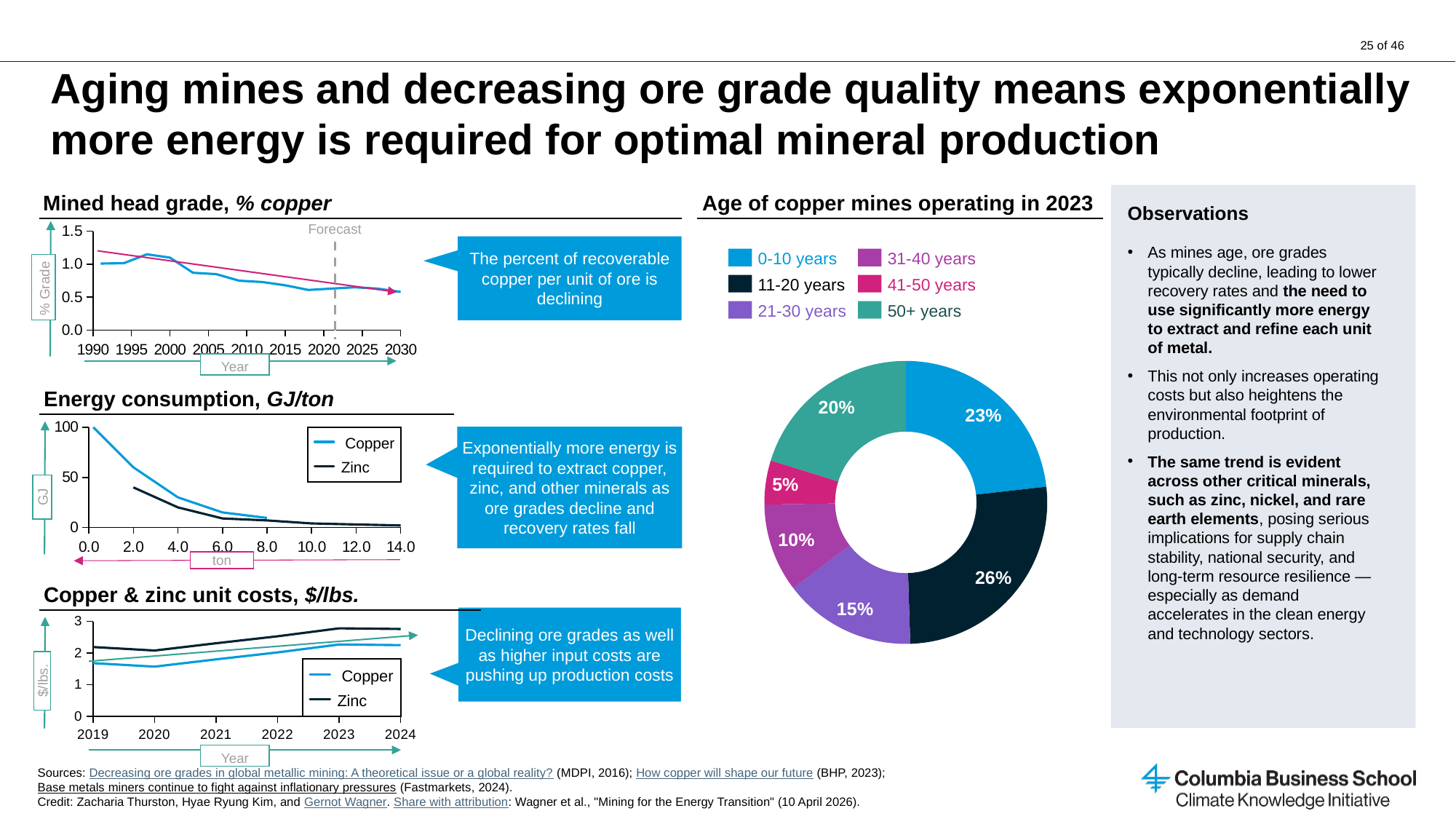
In the 'Mined head grade, % copper' chart, does the head grade rise or fall from 1990 to 2030? Fall How many series does the legend of the 'Energy consumption, GJ/ton' chart list? 2 In the 'Age of copper mines operating in 2023' chart, what share of mines are 50+ years old? 20% What kind of chart is 'Age of copper mines operating in 2023'? Pie (donut) chart In the 'Age of copper mines operating in 2023' chart, what share of mines are 11-20 years old? 26% How many age groups does the legend of the 'Age of copper mines operating in 2023' chart list? 6 In the 'Age of copper mines operating in 2023' chart, which age group has the smallest share? 41-50 years In the 'Age of copper mines operating in 2023' chart, what is the difference between the shares for 0-10 years and 21-30 years? 8% In the 'Copper & zinc unit costs, $/lbs.' chart, is the value for Zinc in 2023 greater or less than 2? greater In the 'Age of copper mines operating in 2023' chart, which is larger: the share for 31-40 years or the share for 50+ years? 50+ years In the 'Energy consumption, GJ/ton' chart, is the Copper value at 0.0 greater or less than 50? greater In the 'Age of copper mines operating in 2023' chart, which age group has the largest share? 11-20 years